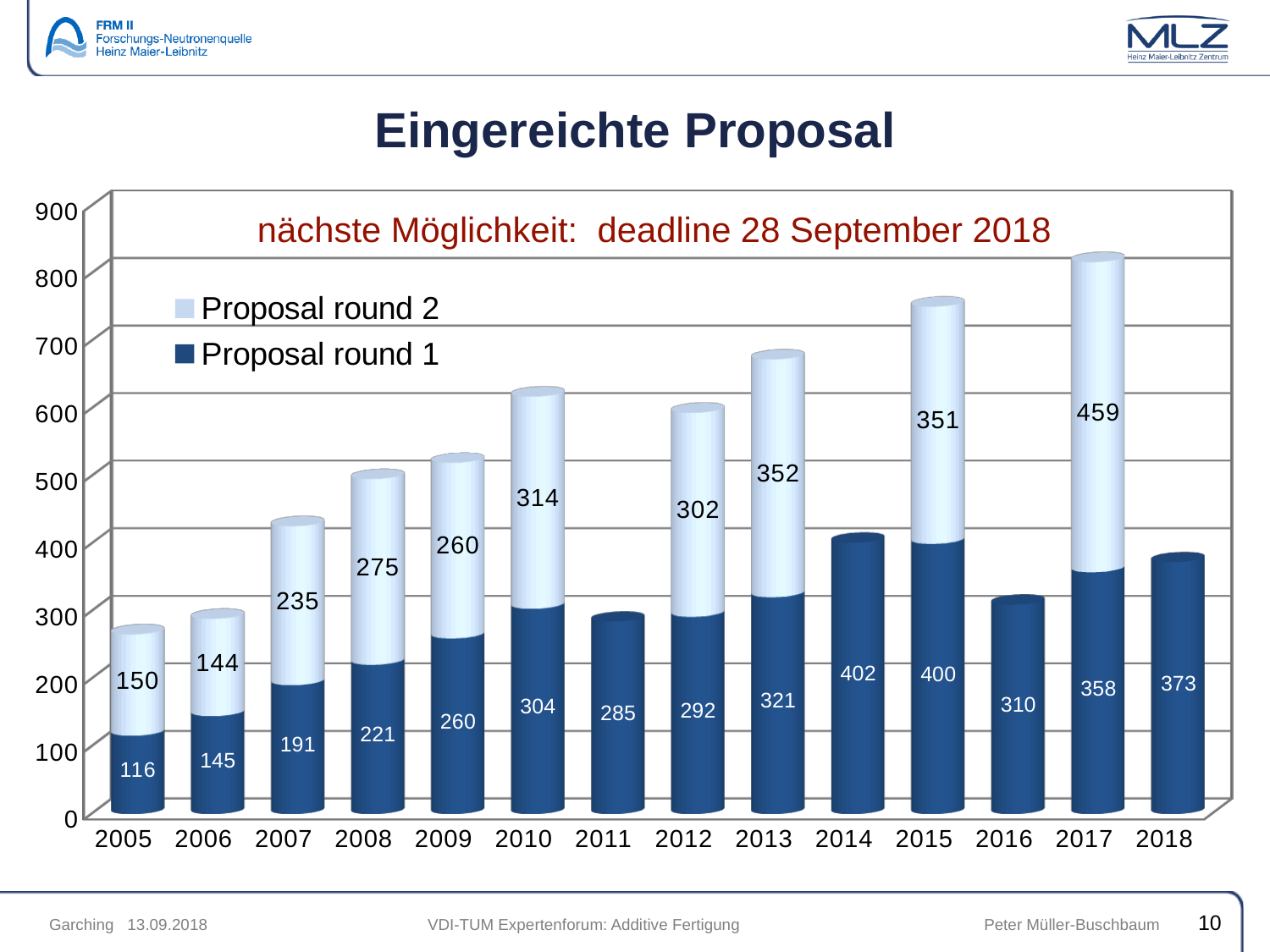
Which is larger in 2015, Proposal round 1 or Proposal round 2? Proposal round 1 What is the value for Proposal round 1 in 2014? 402 Which year has the highest value for Proposal round 2? 2017 What type of chart is shown on the slide? stacked bar chart What is the difference between Proposal round 2 and Proposal round 1 in 2013? 31 How many years are shown on the x axis? 14 Which year has the lowest value for Proposal round 1? 2005 How many series does the legend list? 2 What is the total of the stacked bar for 2017? 817 What is the title of the chart? Eingereichte Proposal What is the value for Proposal round 2 in 2017? 459 What is the value for Proposal round 1 in 2005? 116